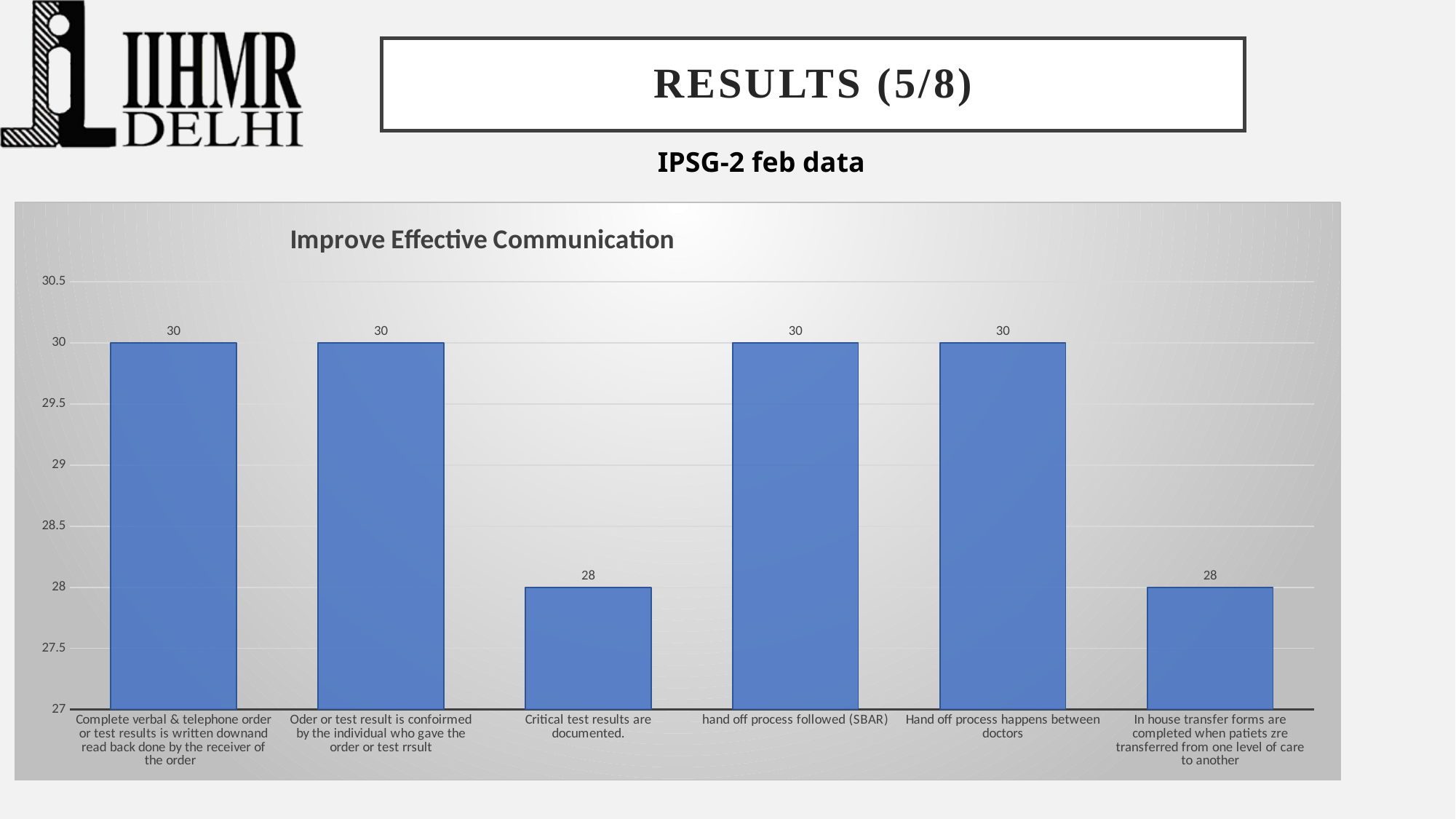
What is the value for "In house transfer forms are completed when patiets zre transferred from one level of care to another"? 28 How many categories are shown on the chart? 6 What kind of chart is shown on the slide? bar chart Which is larger: the value for "Oder or test result is confoirmed by the individual who gave the order or test rrsult" or the value for "Critical test results are documented."? Oder or test result is confoirmed by the individual who gave the order or test rrsult What is the difference between the value for "hand off process followed (SBAR)" and the value for "Critical test results are documented."? 2 What is the title of the chart? Improve Effective Communication What is the value for "Hand off process happens between doctors"? 30 What is the value for "Critical test results are documented."? 28 Is the value for "Hand off process happens between doctors" greater or less than 29.5? greater Is the value for "Critical test results are documented." greater or less than 29? less How many categories have a value of 28? 2 What is the value for "hand off process followed (SBAR)"? 30